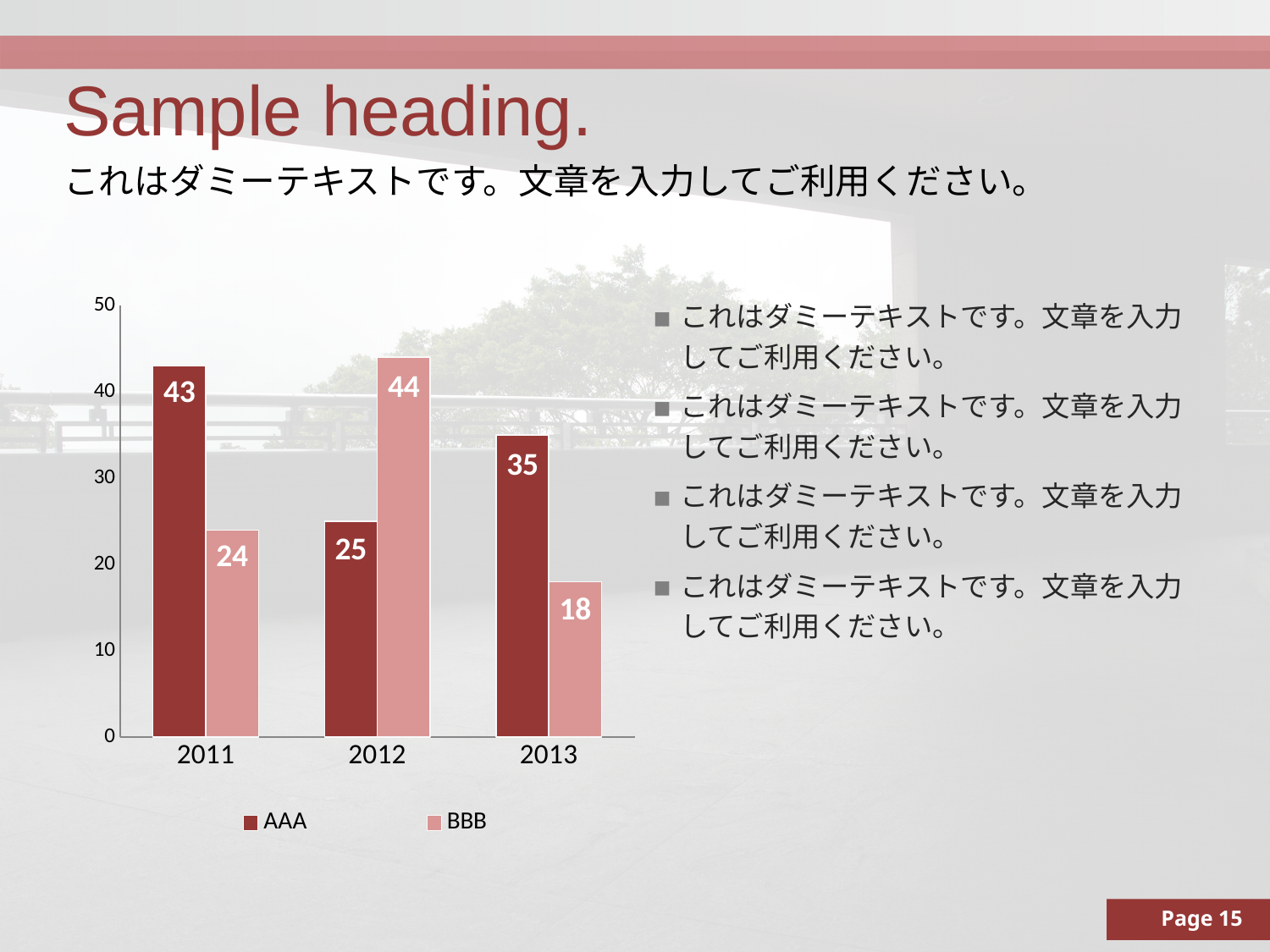
What is the difference between AAA and BBB in 2013? 17 How many series does the legend list? 2 What kind of chart is shown on the slide? Bar chart Is the value for AAA in 2013 greater or less than 30? greater What is the value for BBB in 2012? 44 Which year has the highest value for AAA? 2011 What is the value for AAA in 2011? 43 What is the value for AAA in 2012? 25 Which is larger in 2012, AAA or BBB? BBB What is the value for BBB in 2013? 18 Which year has the lowest value for BBB? 2013 How many years are shown on the x axis? 3